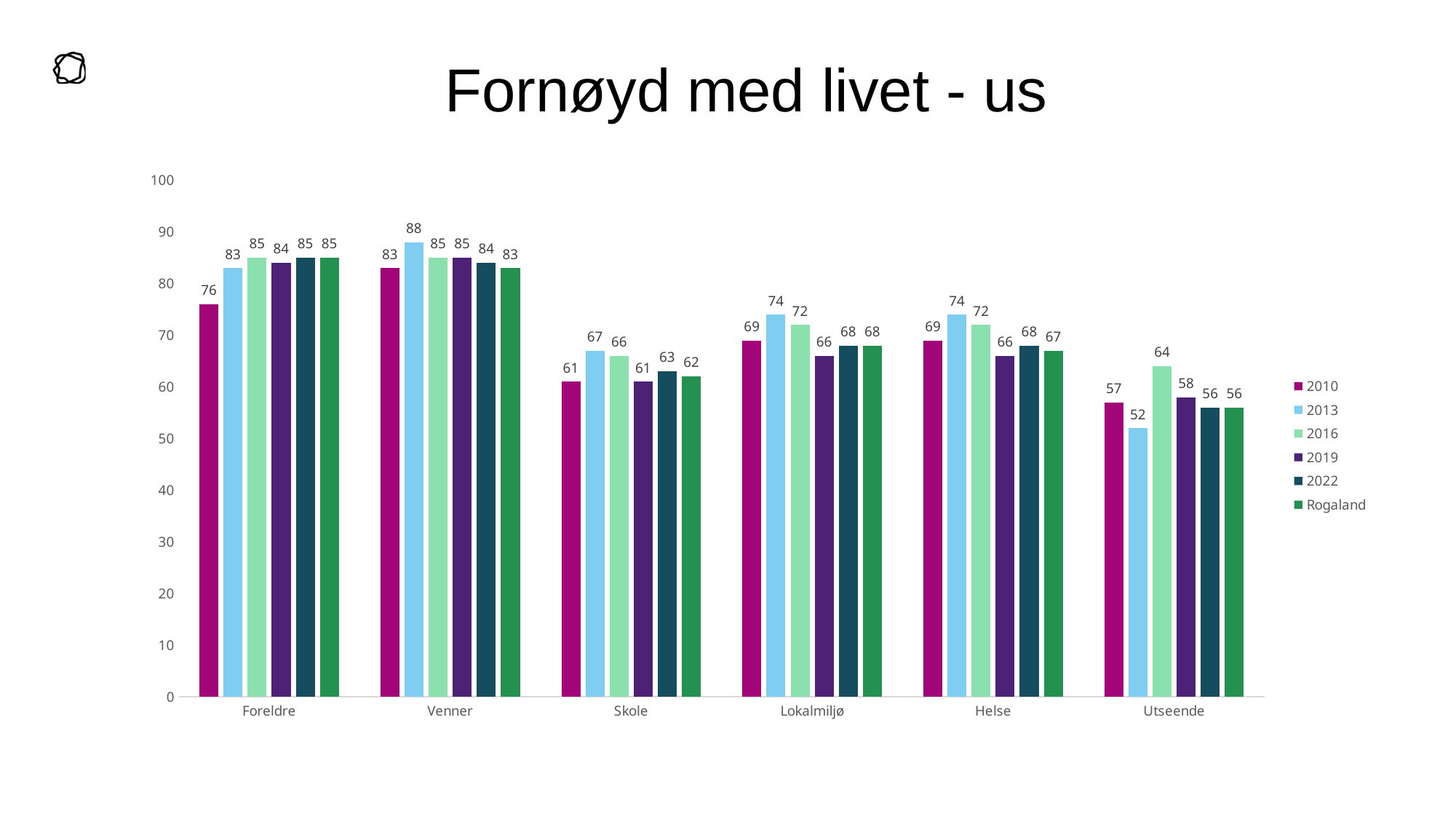
Which is larger in the Lokalmiljø category, the 2013 value or the 2019 value? 2013 How many categories are shown on the x axis? 6 What is the value for 2013 in the Venner category? 88 Which category has the lowest value for the 2013 series? Utseende What is the value for 2010 in the Foreldre category? 76 Which category has the highest value for the 2013 series? Venner What is the title of the chart on the slide? Fornøyd med livet - us How many series does the legend list? 6 What kind of chart is shown on the slide? Bar chart What is the difference between the 2016 and 2013 values in the Utseende category? 12 What is the value for Rogaland in the Utseende category? 56 What is the value for 2016 in the Skole category? 66